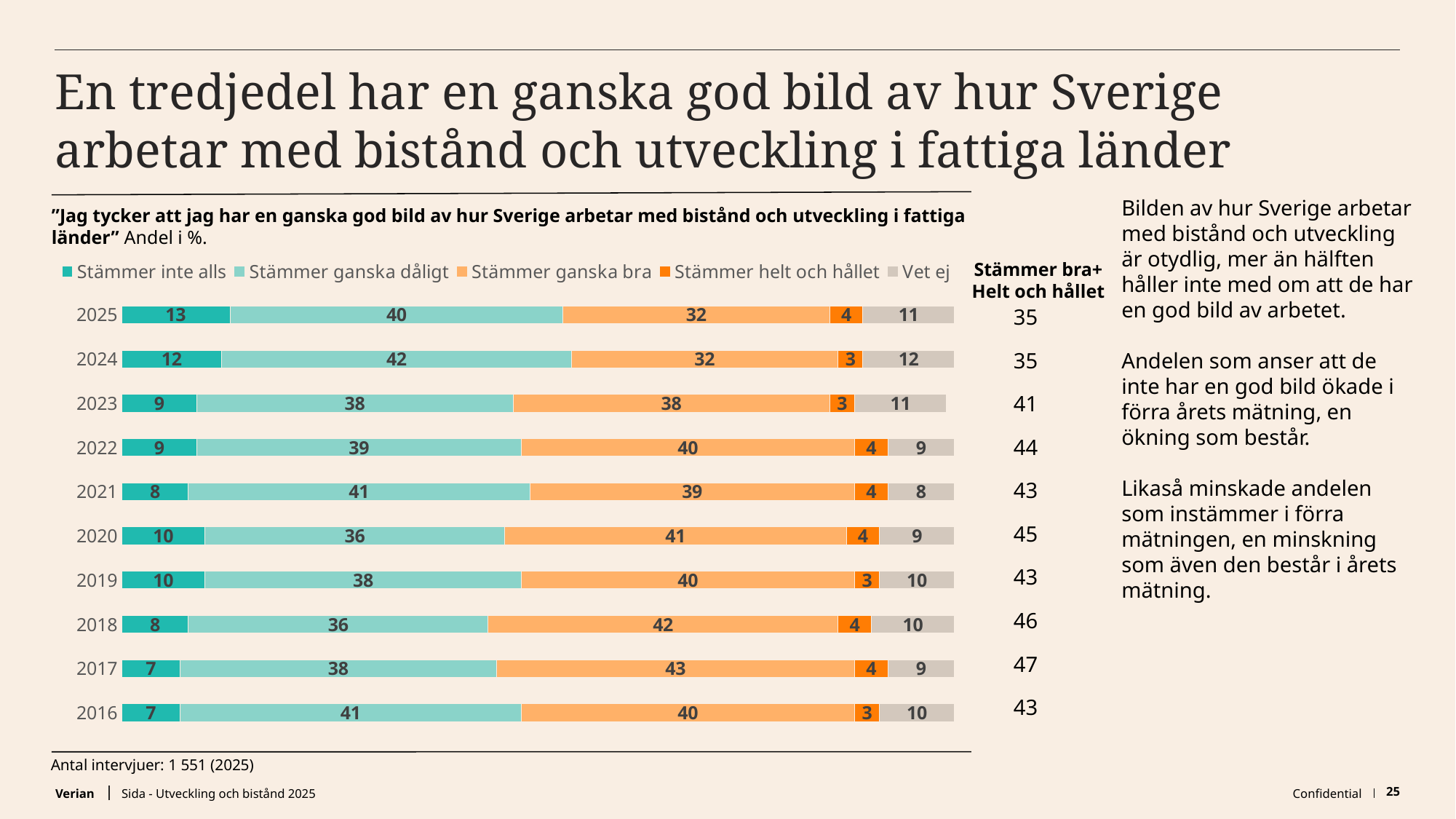
What kind of chart is shown on the slide? Stacked bar chart Which year has the larger "Stämmer ganska bra" value, 2023 or 2025? 2023 How many series does the legend list? 5 What is the value for "Stämmer inte alls" in 2024? 12 How many years are shown in the chart? 10 What is the total of the stacked bar for 2025? 100 What is the difference between the "Stämmer ganska dåligt" values for 2024 and 2025? 2 What is the "Vet ej" value for 2022? 9 Which year has the highest value for "Stämmer ganska bra"? 2017 What is the value for "Stämmer ganska bra" in 2025? 32 Which year has the highest value for "Stämmer inte alls"? 2025 Does the "Stämmer inte alls" value rise or fall from 2016 to 2025? Rises